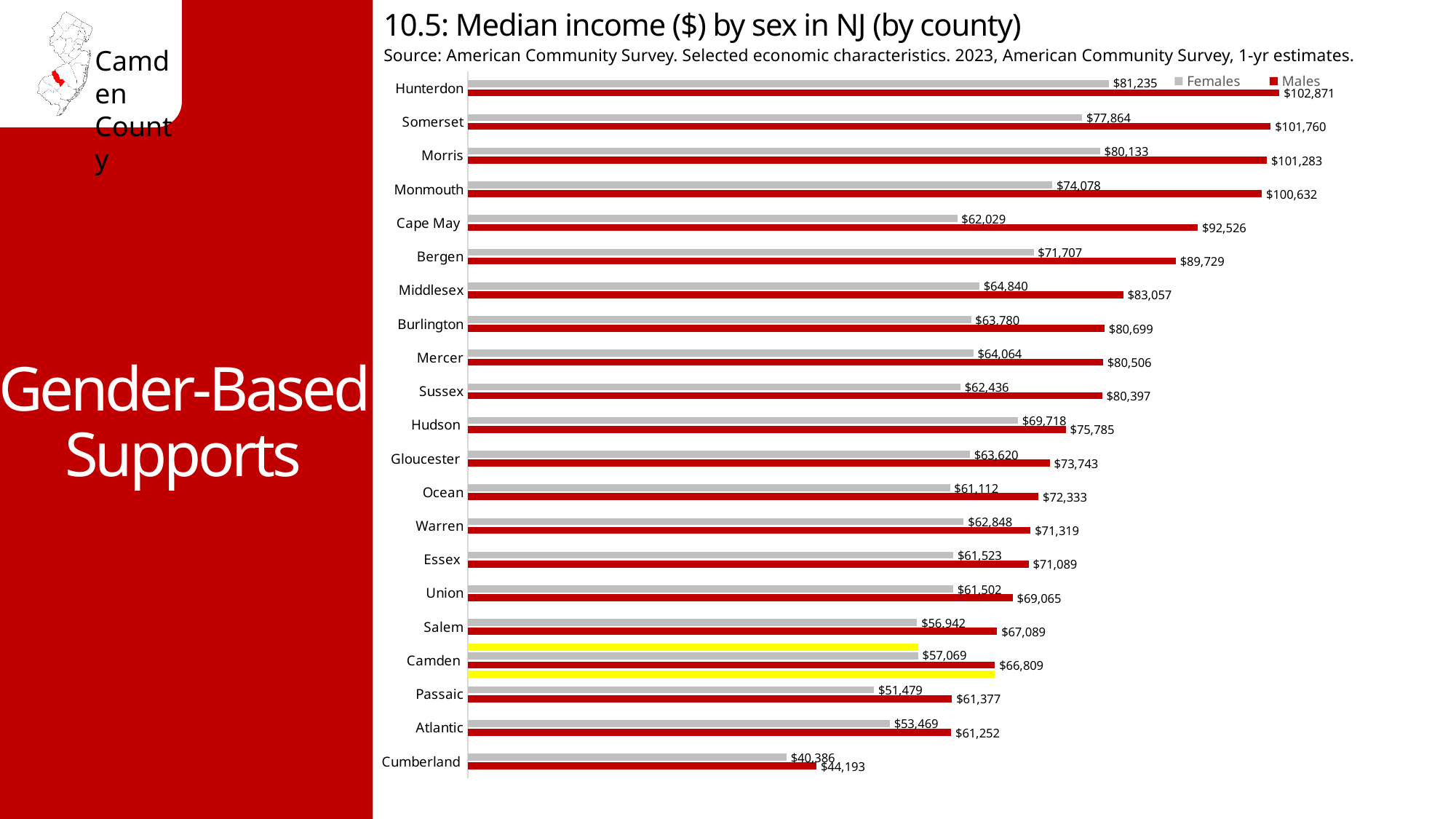
How many counties are shown in the chart? 21 Which colour represents the Males series in the chart? Red How many series does the legend list? 2 What is the median income for females in Hunterdon County? $81,235 Which is larger, the female median income in Bergen or in Hudson? Bergen Which county has the highest median income for males? Hunterdon What kind of chart is shown on the slide? Bar chart Which county has the lowest median income for females? Cumberland What is the median income for males in Camden County? $66,809 What is the difference between the male and female median income in Camden County? $9,740 What is the difference between the male and female median income in Hunterdon County? $21,636 What is the median income for females in Cumberland County? $40,386